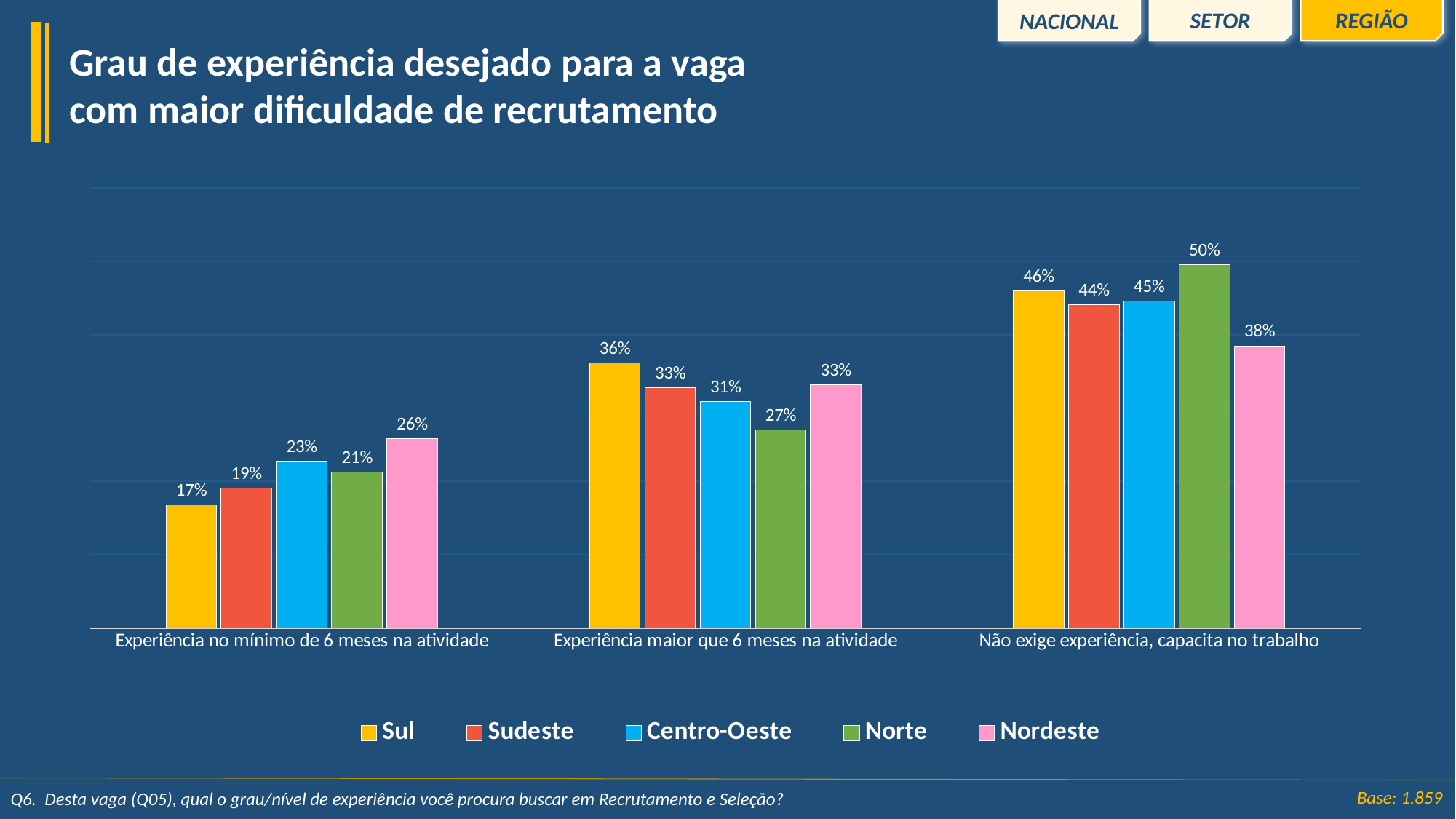
What kind of chart is shown on the slide? Bar chart Which region has the lowest value in the category 'Não exige experiência, capacita no trabalho'? Nordeste How many series does the legend list? 5 Which is larger in the category 'Não exige experiência, capacita no trabalho': Sudeste or Centro-Oeste? Centro-Oeste Which colour represents Nordeste in the legend? Pink How many categories are shown on the x axis? 3 Which region has the highest value in the category 'Experiência no mínimo de 6 meses na atividade'? Nordeste What is the difference between the Sul and Norte values in the category 'Experiência maior que 6 meses na atividade'? 9% What is the value for Sul in the category 'Experiência no mínimo de 6 meses na atividade'? 17% What is the value for Centro-Oeste in the category 'Experiência maior que 6 meses na atividade'? 31% Do the Sul values rise or fall across the categories from left to right? Rise What is the value for Norte in the category 'Não exige experiência, capacita no trabalho'? 50%